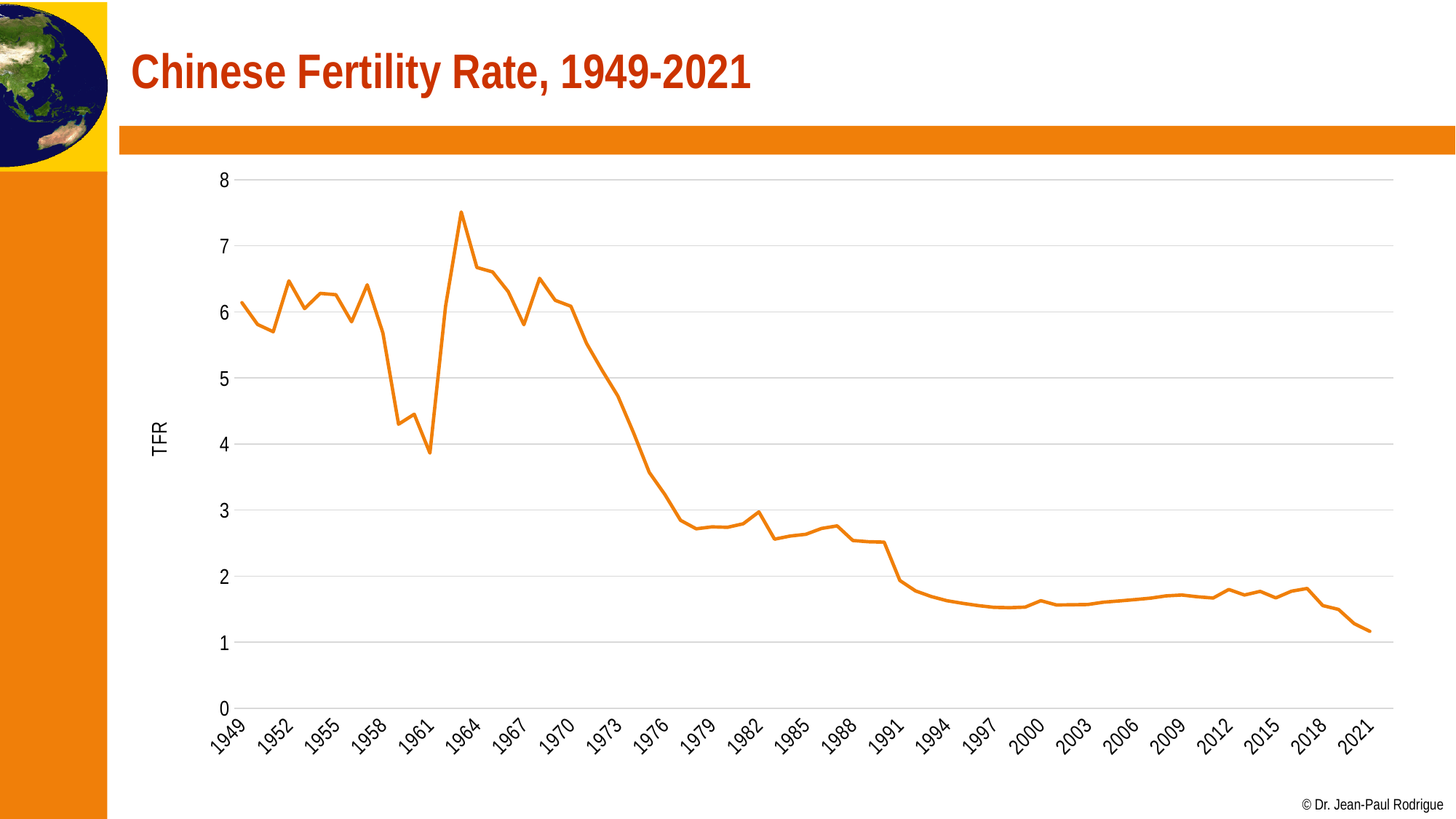
Is the value for 1994 greater or less than 2? less Which year has the larger value, 1958 or 1961? 1958 Is the value for 1976 greater or less than 4? less Is the value for 2021 greater or less than 2? less What kind of chart is shown on the slide? line chart Which year has the larger value, 1949 or 2021? 1949 What is the title of the chart? Chinese Fertility Rate, 1949-2021 How many year labels are shown on the horizontal axis? 25 What is the label on the vertical axis? TFR Overall, does the fertility rate rise or fall from 1949 to 2021? fall